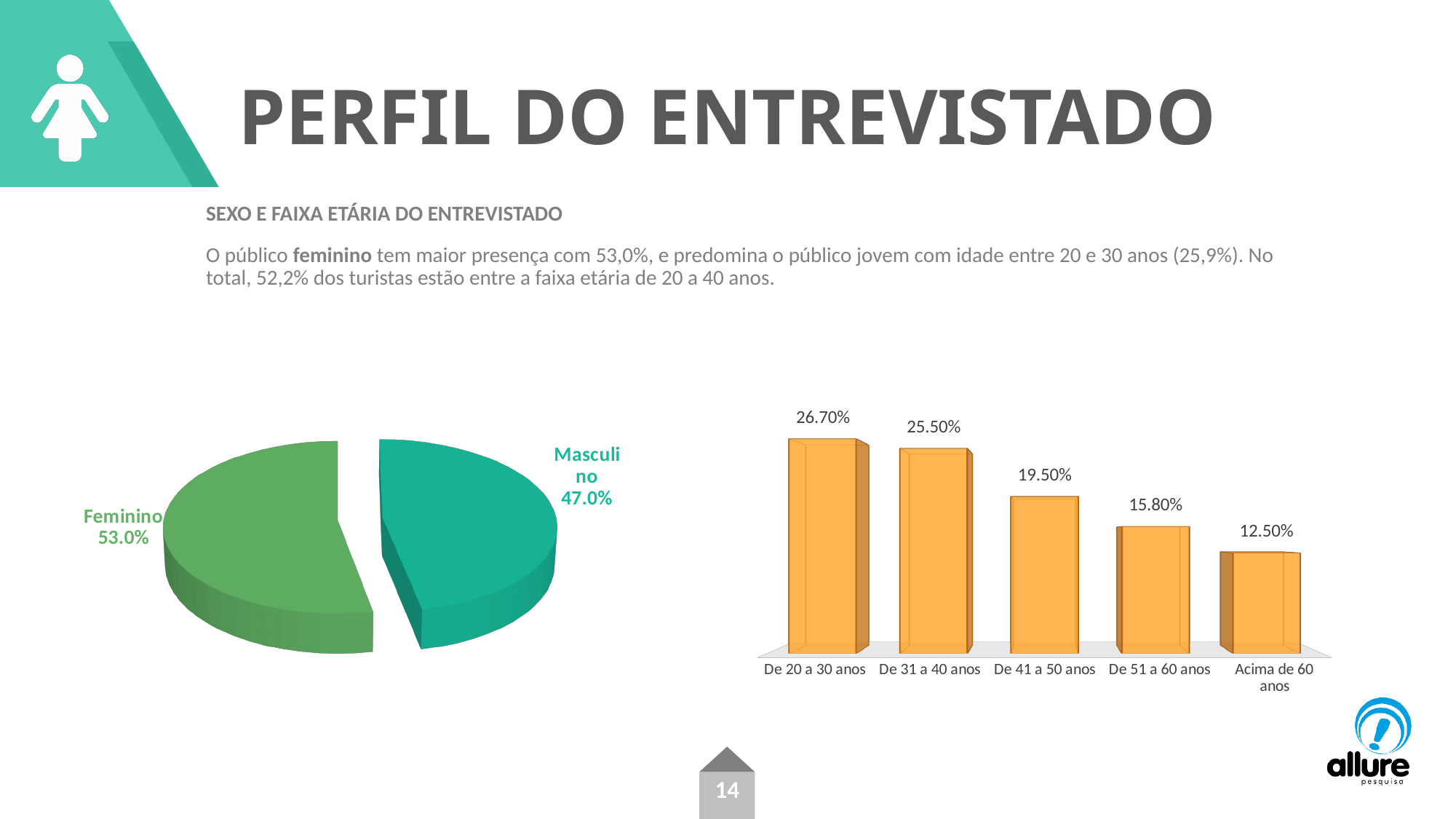
What kind of chart is the chart on the left of the slide? Pie chart In the bar chart on the right, how many age groups are shown? 5 In the bar chart on the right, which age group has the highest value? De 20 a 30 anos In the bar chart on the right, what is the difference between De 41 a 50 anos and De 51 a 60 anos? 3.70% In the bar chart on the right, what is the value for Acima de 60 anos? 12.50% In the pie chart on the left, how many slices are there? 2 In the bar chart on the right, what is the value for De 20 a 30 anos? 26.70% In the pie chart on the left, which slice is larger, Feminino or Masculino? Feminino In the bar chart on the right, which age group has the lowest value? Acima de 60 anos In the bar chart on the right, do the values rise or fall from left to right along the x axis? Fall In the pie chart on the left, what share is labelled for Feminino? 53.0% In the pie chart on the left, what share is labelled for Masculino? 47.0%